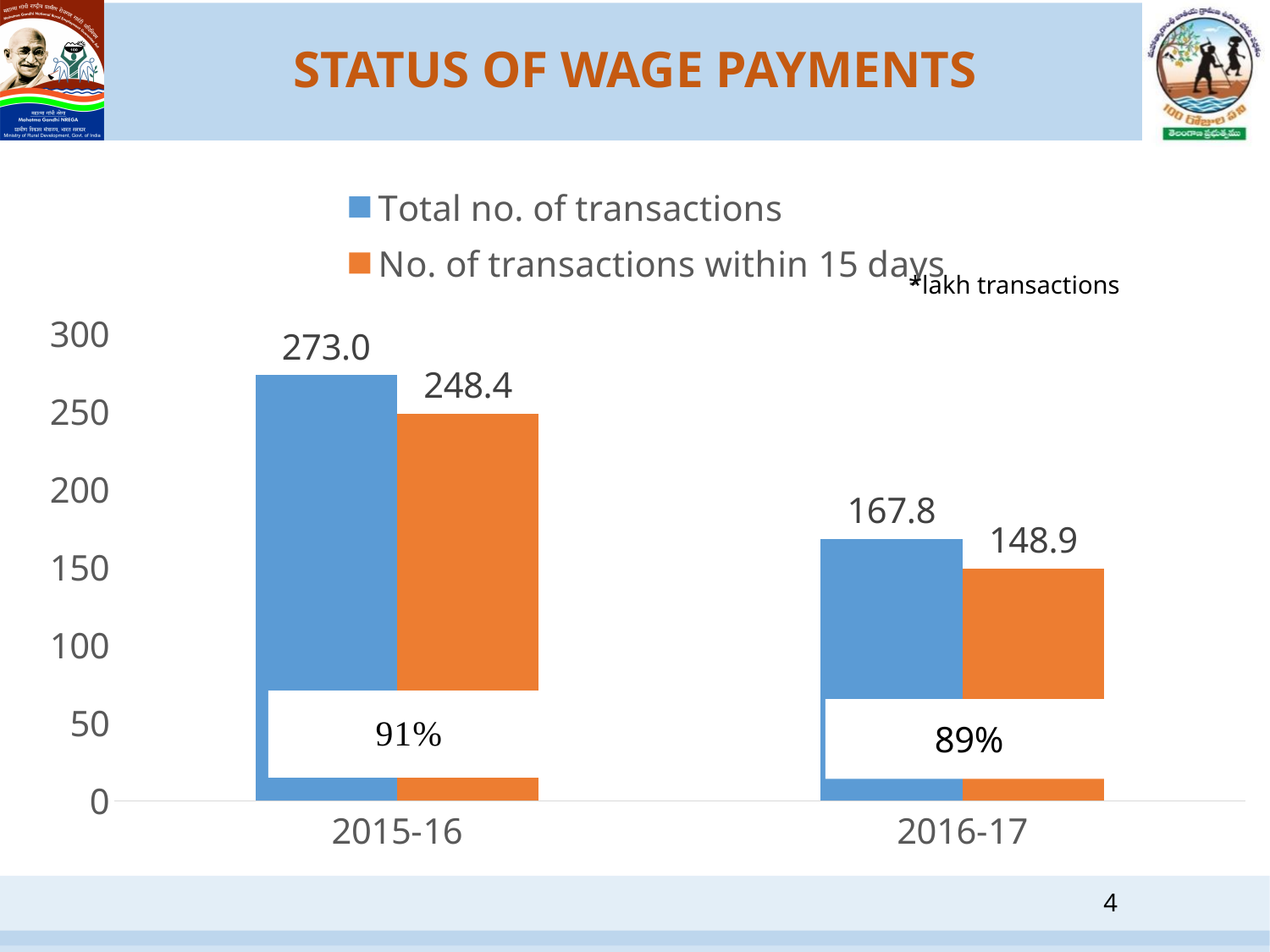
Which year has the higher total no. of transactions? 2015-16 What is the no. of transactions within 15 days for 2015-16? 248.4 What kind of chart is shown on the slide? Bar chart What is the difference between the total no. of transactions and the no. of transactions within 15 days in 2015-16? 24.6 Which year has the lower no. of transactions within 15 days? 2016-17 What is the total no. of transactions for 2016-17? 167.8 Is the total no. of transactions for 2016-17 greater or less than 150? greater What percentage label is shown on the 2016-17 bars? 89% What is the total no. of transactions for 2015-16? 273.0 What is the no. of transactions within 15 days for 2016-17? 148.9 What is the difference in total no. of transactions between 2015-16 and 2016-17? 105.2 How many series does the legend list? 2